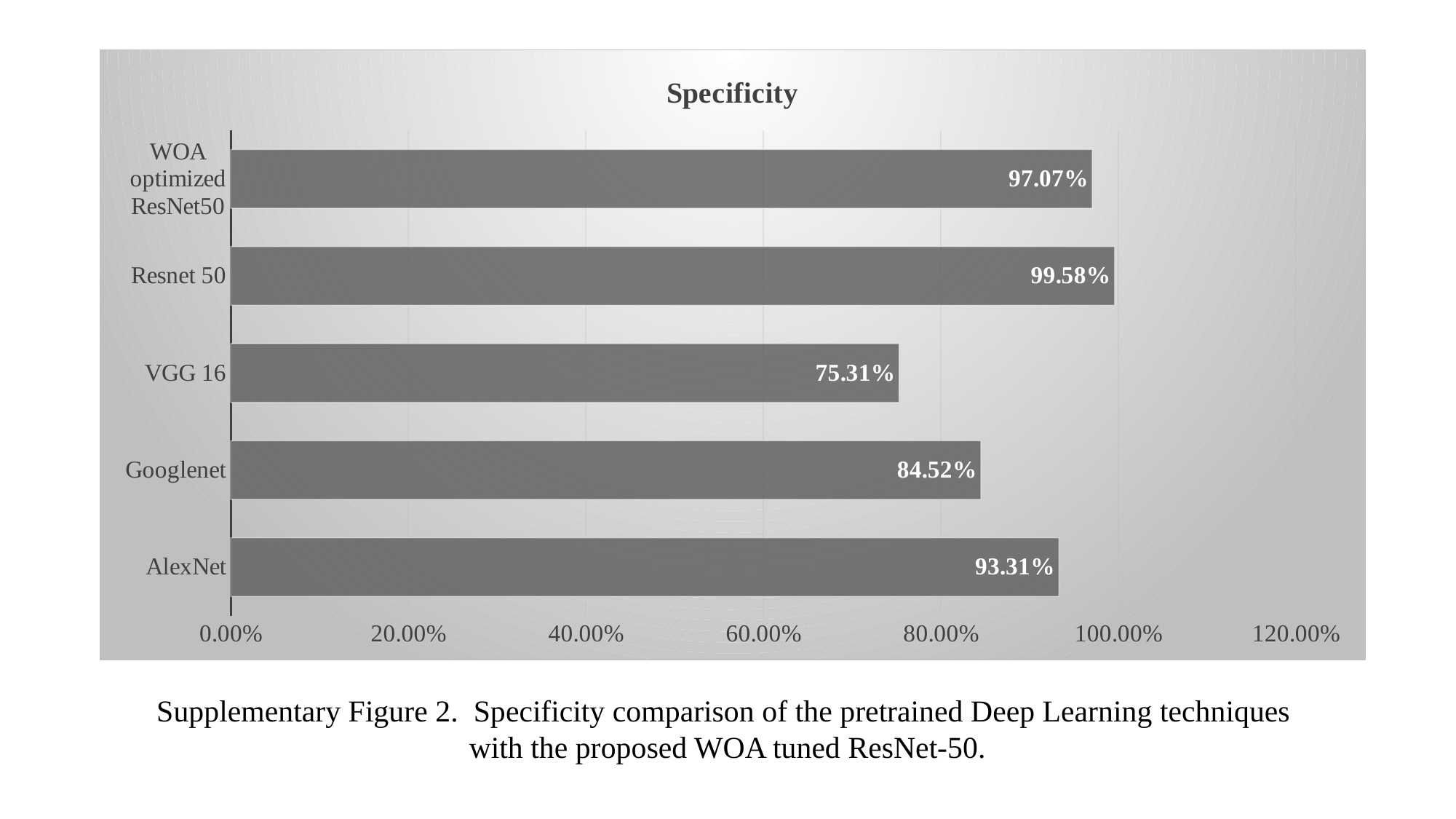
What is the specificity value for WOA optimized ResNet50? 97.07% What is the specificity value for VGG 16? 75.31% How many models are compared in the chart? 5 What kind of chart is shown on the slide? Bar chart Which model has the highest specificity? Resnet 50 Which has a higher specificity, AlexNet or Googlenet? AlexNet What is the title of the chart? Specificity What is the difference in specificity between AlexNet and Googlenet? 8.79% Is the specificity value for VGG 16 greater or less than 80.00%? less What is the specificity value for Googlenet? 84.52% What is the difference in specificity between Resnet 50 and WOA optimized ResNet50? 2.51% Which model has the lowest specificity? VGG 16